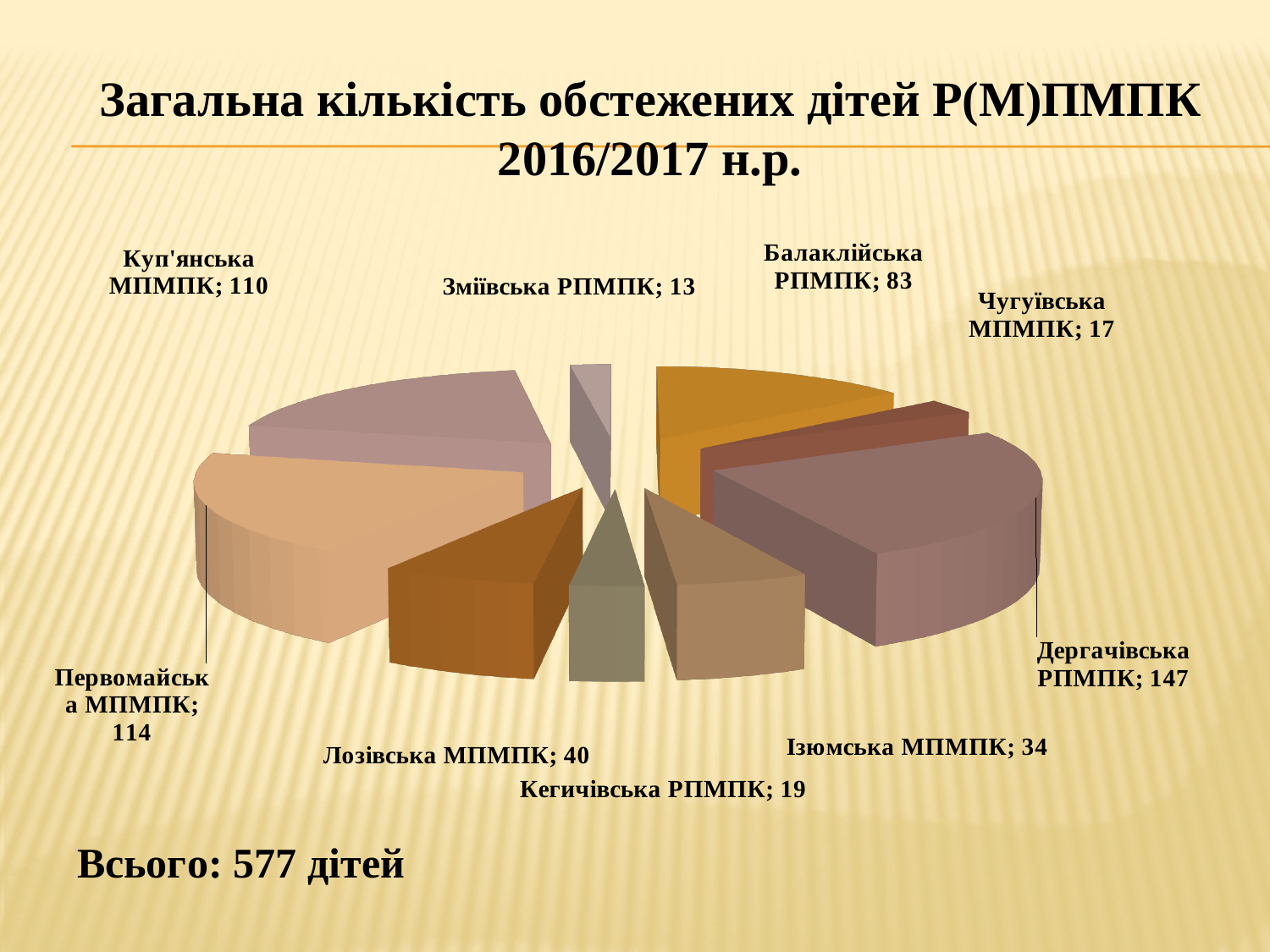
What is the difference between the values for Дергачівська РПМПК and Первомайська МПМПК? 33 How many categories are shown in the pie chart? 9 What total number of children is stated on the slide? 577 дітей Which is larger, the value for Первомайська МПМПК or Куп'янська МПМПК? Первомайська МПМПК What kind of chart is shown on the slide? pie chart Which category has the largest slice of the pie? Дергачівська РПМПК What is the value for Зміївська РПМПК? 13 What is the value for Лозівська МПМПК? 40 Which category has the smallest slice of the pie? Зміївська РПМПК How many children were examined by Дергачівська РПМПК? 147 What is the difference between the values for Балаклійська РПМПК and Ізюмська МПМПК? 49 What is the value for Куп'янська МПМПК? 110